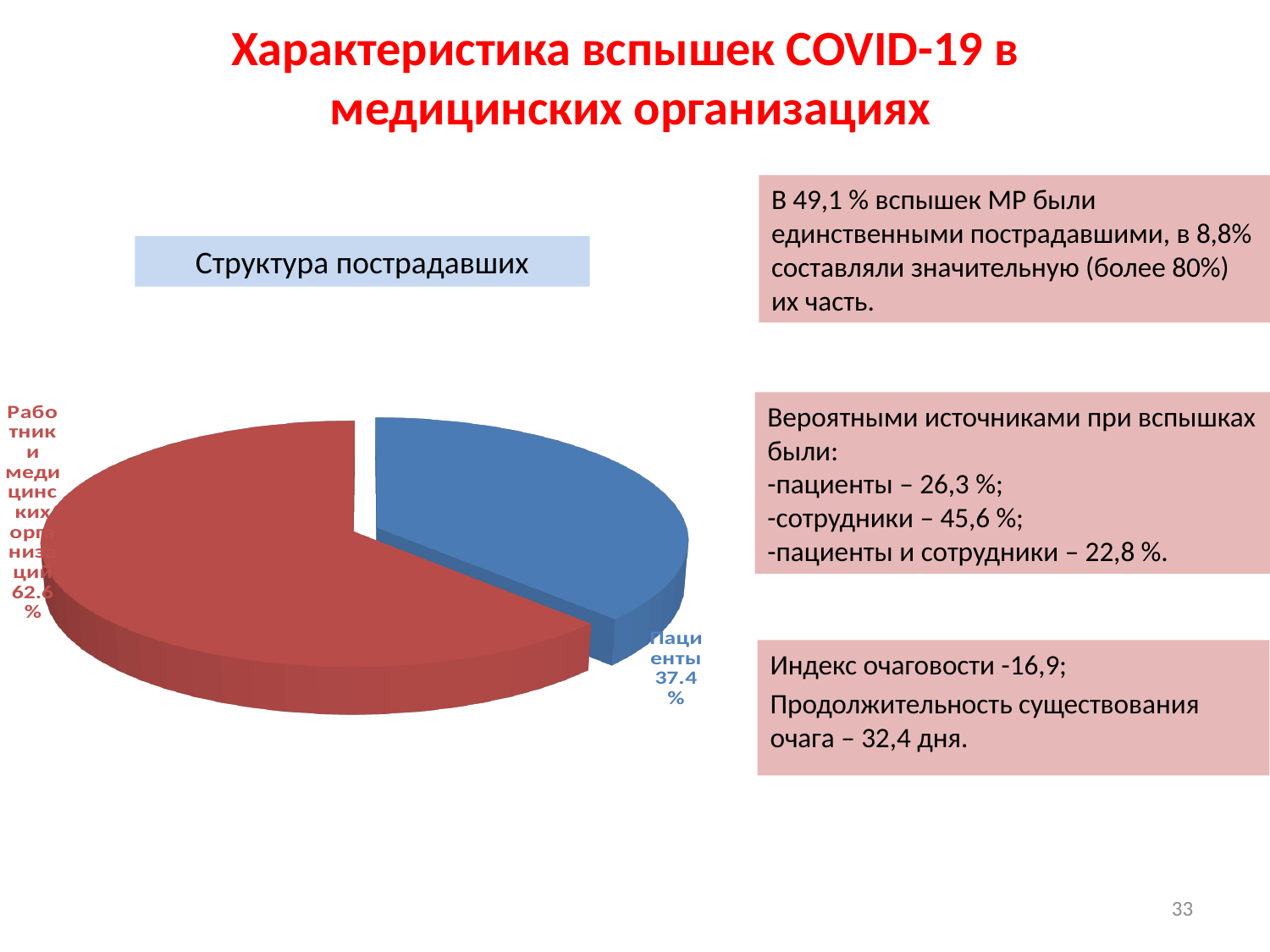
What share of the pie chart is labelled "Работники медицинских организаций"? 62.6% How many slices does the pie chart have? 2 What is the title shown above the pie chart? Структура пострадавших What share of the pie chart is labelled "Пациенты"? 37.4% Is the share for "Пациенты" in the pie chart greater or less than 50%? less What type of chart is shown under the heading "Структура пострадавших"? pie chart By how many percentage points does the "Работники медицинских организаций" slice exceed the "Пациенты" slice? 25.2 What colour is the "Пациенты" slice of the pie chart? blue Which slice of the pie chart is the smallest? Пациенты Which slice of the pie chart is the largest? Работники медицинских организаций Which is larger in the pie chart: the share for "Пациенты" or the share for "Работники медицинских организаций"? Работники медицинских организаций